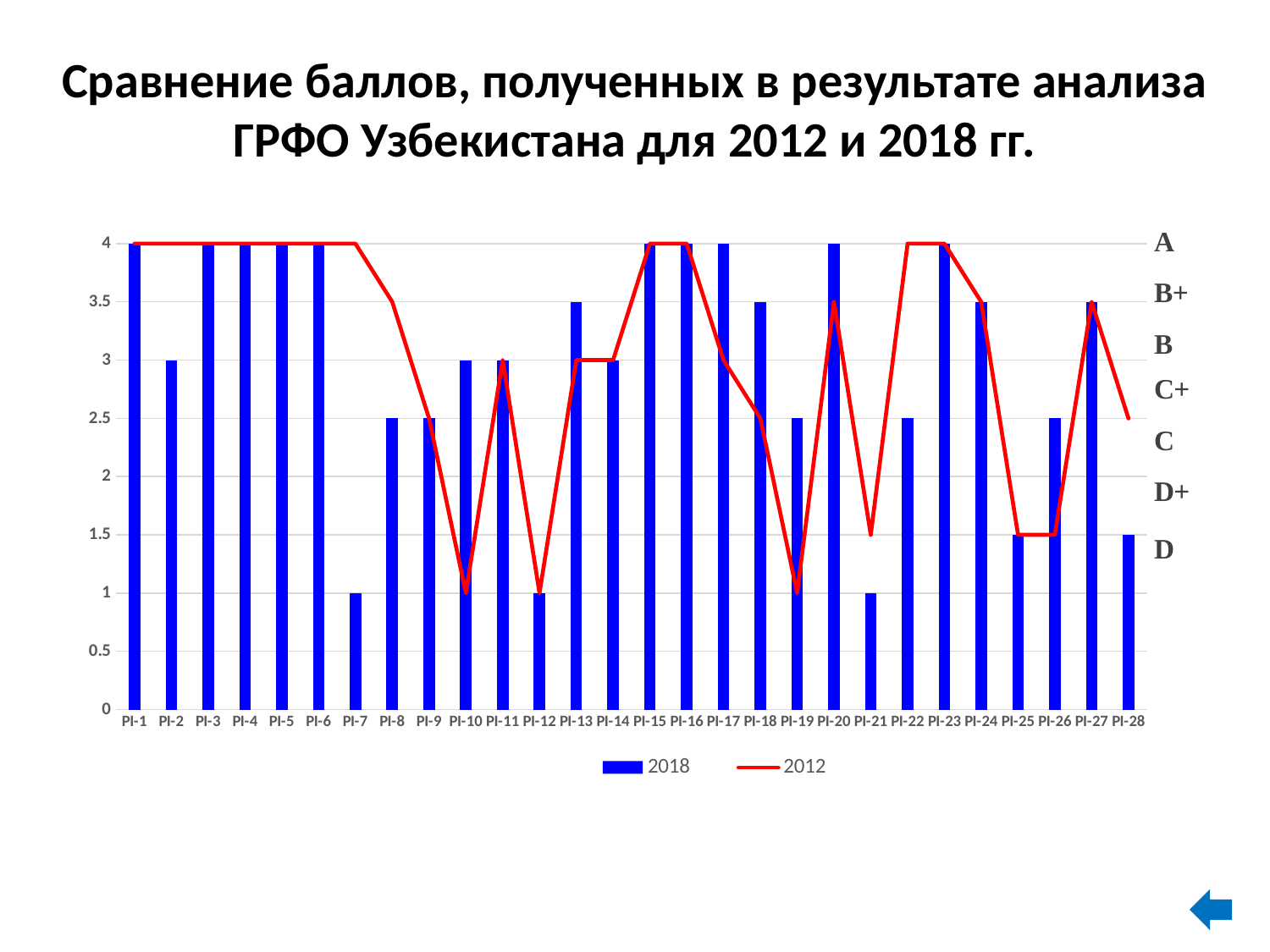
What kind of chart is shown on the slide? Combined bar and line chart How many PI categories are shown on the x axis? 28 Which is larger for PI-26, the 2018 value or the 2012 value? 2018 What is the 2018 value for PI-7? 1 What is the 2018 value for PI-13? 3.5 What is the 2012 value for PI-10? 1 What is the difference between the 2018 and 2012 values for PI-19? 1.5 Is the 2018 value for PI-21 greater or less than 2? less Is the 2012 value for PI-8 greater or less than 3? greater Which series is drawn as a red line? 2012 How many series does the legend list? 2 What is the 2012 value for PI-28? 2.5